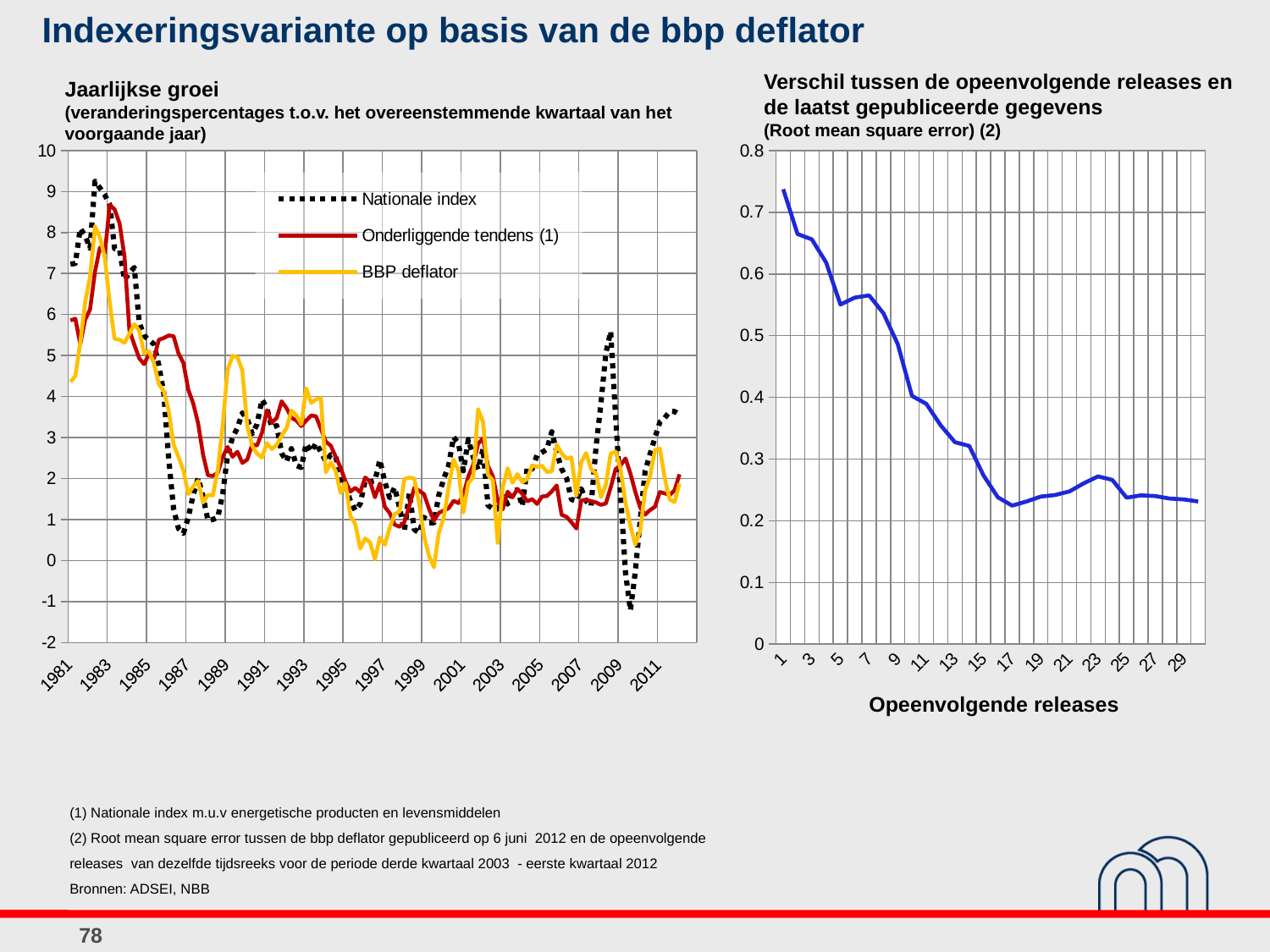
In the left chart 'Jaarlijkse groei', is the lowest value of the Nationale index around 2009 greater or less than 0? less How many series does the legend of the left chart 'Jaarlijkse groei' list? 3 In the right chart about 'Root mean square error', do the values generally rise or fall as the release number increases? fall What kind of chart is the right chart about 'Root mean square error'? line chart What is the x-axis title of the right chart about 'Root mean square error'? Opeenvolgende releases In the left chart 'Jaarlijkse groei', do the values of the Onderliggende tendens (1) series overall rise or fall from 1981 to 2011? fall In the right chart about 'Root mean square error', is the value for release 1 greater or less than 0.7? greater In the left chart 'Jaarlijkse groei', which series is drawn as a black dotted line? Nationale index In the left chart 'Jaarlijkse groei', is the peak value of the Nationale index around 1982 greater or less than 8? greater What kind of chart is the left chart titled 'Jaarlijkse groei'? line chart